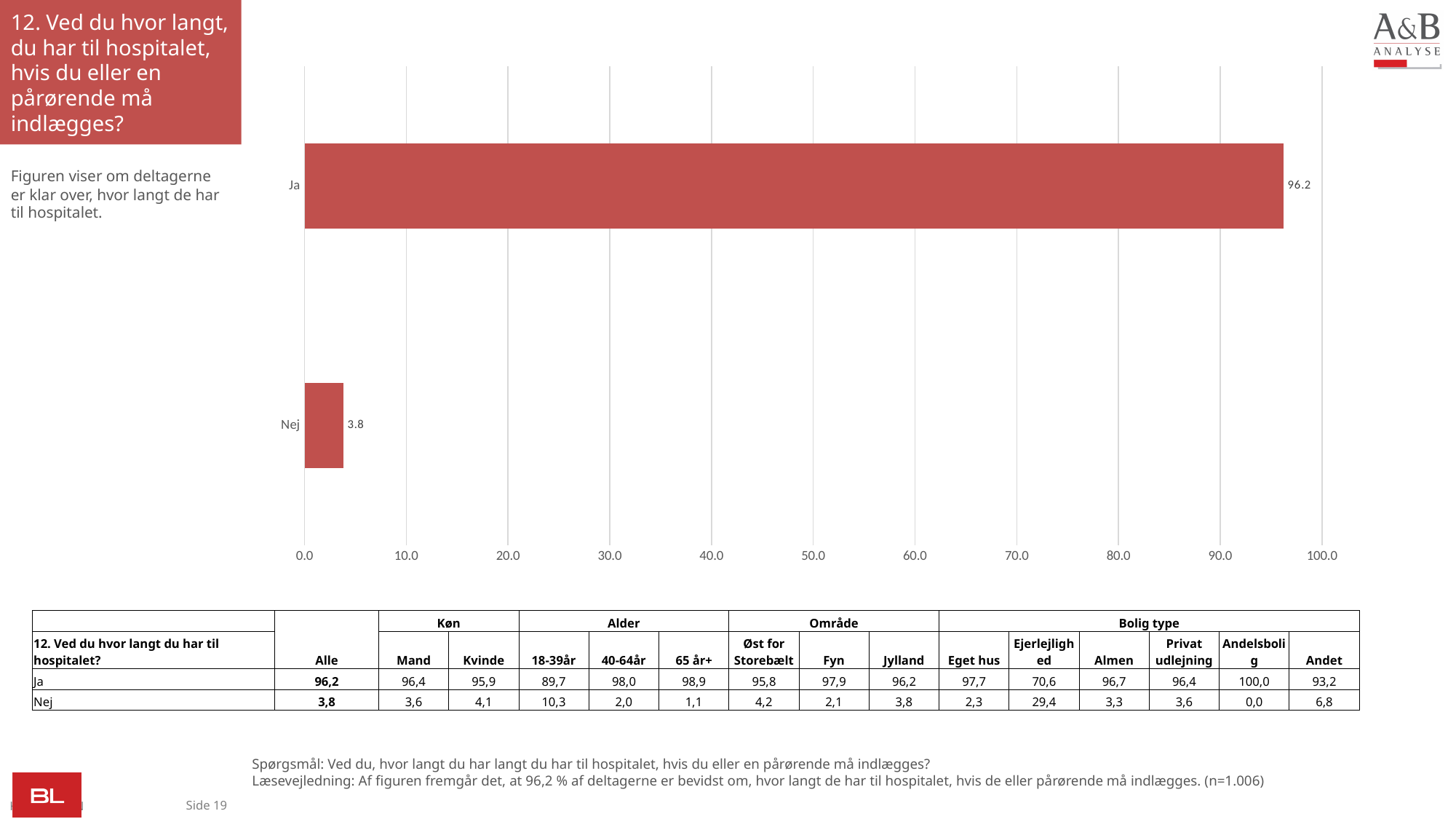
Is the value for "Ja" greater or less than 90.0? greater What is the difference between the values for "Ja" and "Nej"? 92.4 Which category has the highest value in the chart? Ja How many categories are shown in the chart? 2 What is the total of the two bar values in the chart? 100.0 What is the value for "Ja" in the chart? 96.2 What is the value for "Nej" in the chart? 3.8 What kind of chart is shown on the slide? bar chart Which is larger, the value for "Ja" or the value for "Nej"? Ja What is the highest tick value shown on the x axis of the chart? 100.0 Which category has the lowest value in the chart? Nej Is the value for "Nej" greater or less than 10.0? less